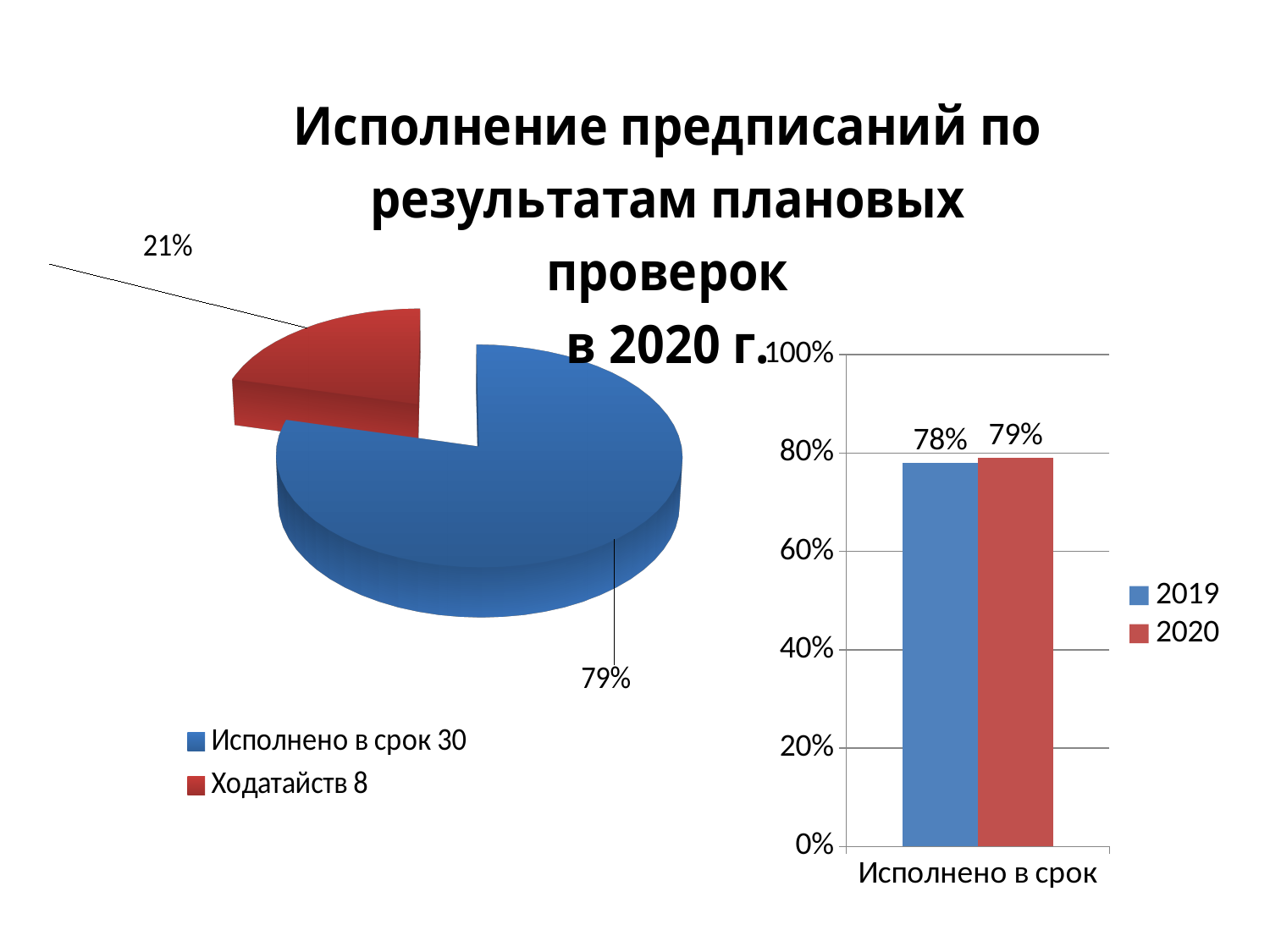
In the pie chart on the left, which slice is the smallest? Ходатайств 8 In the pie chart on the left, what share does the slice 'Ходатайств 8' have? 21% In the bar chart on the right, what is the value for 2019 for 'Исполнено в срок'? 78% What kind of chart is the chart on the left of the slide? pie chart In the pie chart on the left, which slice is the largest? Исполнено в срок 30 How many series does the legend of the bar chart on the right list? 2 In the bar chart on the right, what is the value for 2020 for 'Исполнено в срок'? 79% What kind of chart is the chart on the right of the slide? bar chart In the bar chart on the right, what is the difference between the 2020 and 2019 values for 'Исполнено в срок'? 1% In the bar chart on the right, is the value for 2019 greater or less than 60%? greater How many slices does the pie chart on the left have? 2 In the pie chart on the left, what share does the slice 'Исполнено в срок 30' have? 79%